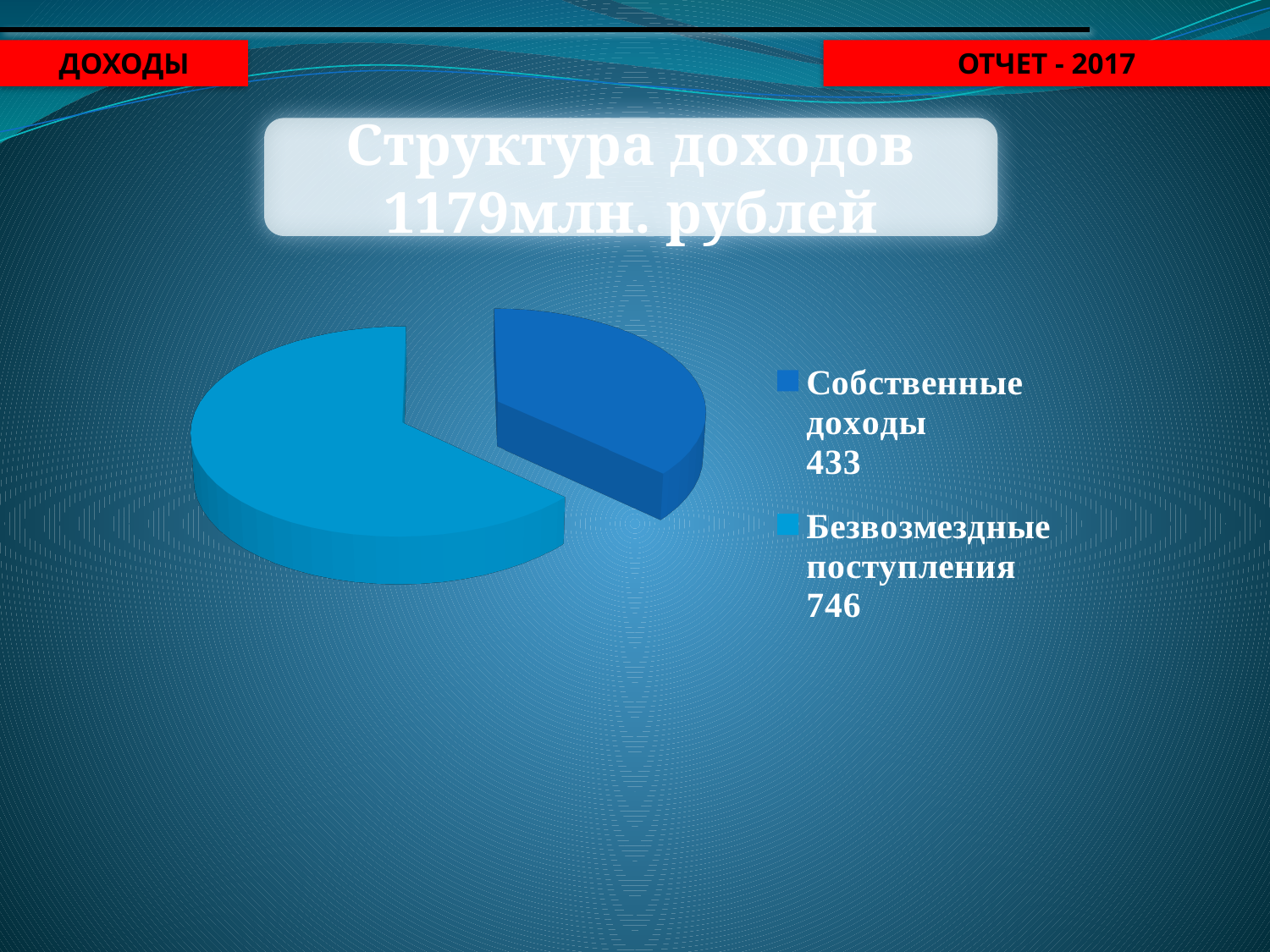
What is the title of the chart? Структура доходов 1179млн. рублей What is the sum of the two slices, Собственные доходы and Безвозмездные поступления? 1179 What is the value for Безвозмездные поступления? 746 Which category has the largest slice of the pie? Безвозмездные поступления Which is larger, Собственные доходы or Безвозмездные поступления? Безвозмездные поступления How many entries does the legend list? 2 What total amount is stated in the chart title? 1179млн. рублей What is the value for Собственные доходы? 433 What is the difference between Безвозмездные поступления and Собственные доходы? 313 What kind of chart is shown on the slide? Pie chart Which category has the smallest slice of the pie? Собственные доходы How many slices does the pie chart have? 2